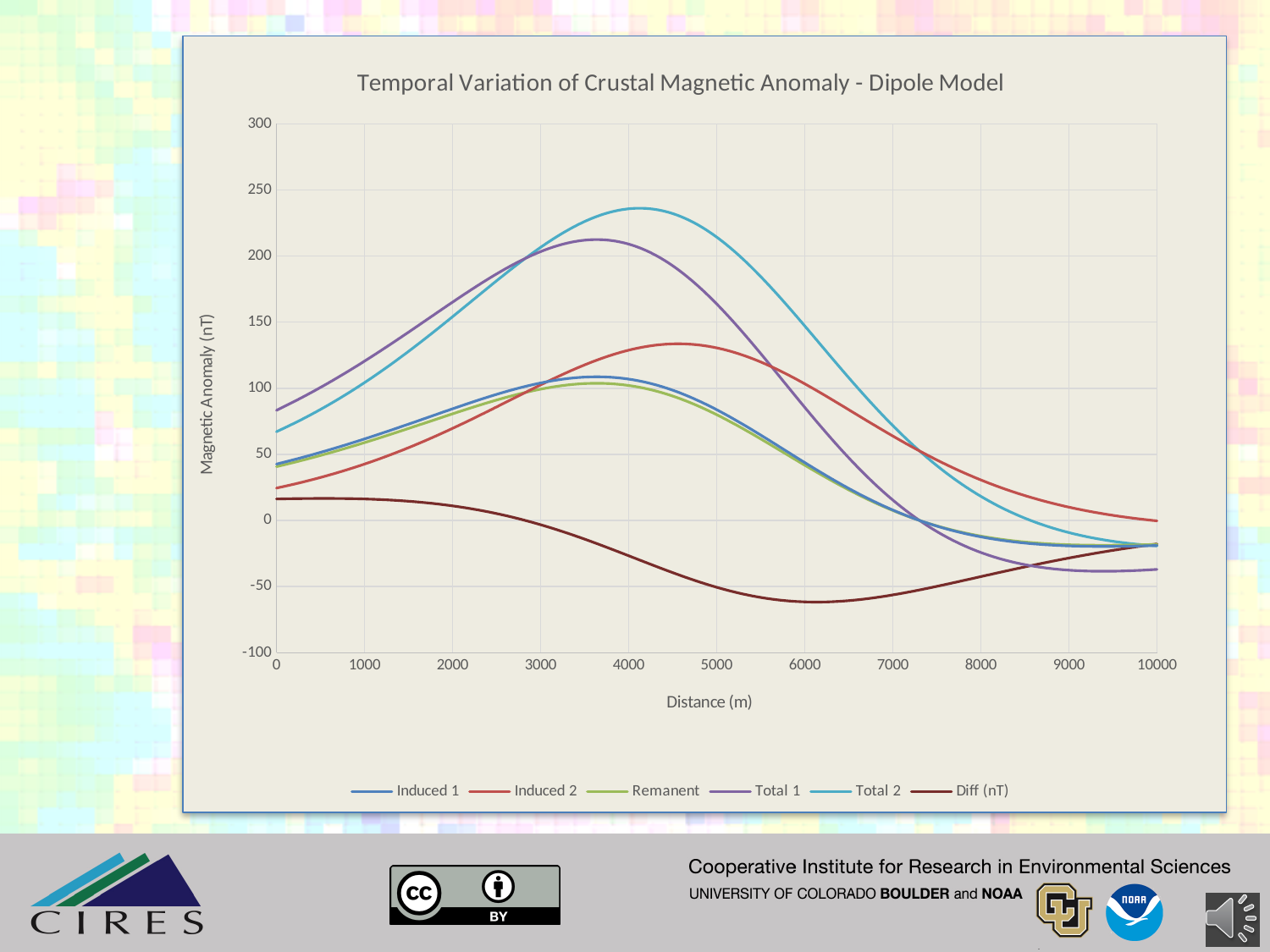
Which series reaches the lowest value on the chart? Diff (nT) Is the value of Total 1 at a distance of 0 m greater or less than 50? greater Is the value of Diff (nT) at a distance of 6000 m greater or less than -50? less Is the peak value of the Total 2 series greater or less than 200? greater At a distance of 8000 m, which series has the larger value, Induced 2 or Total 1? Induced 2 What kind of chart is shown on the slide? line chart What is the title of the chart? Temporal Variation of Crustal Magnetic Anomaly - Dipole Model Which series reaches the highest peak value on the chart? Total 2 How many series does the legend list? 6 Does the Diff (nT) series rise or fall between 0 m and 6000 m? fall What is the label of the x axis? Distance (m)